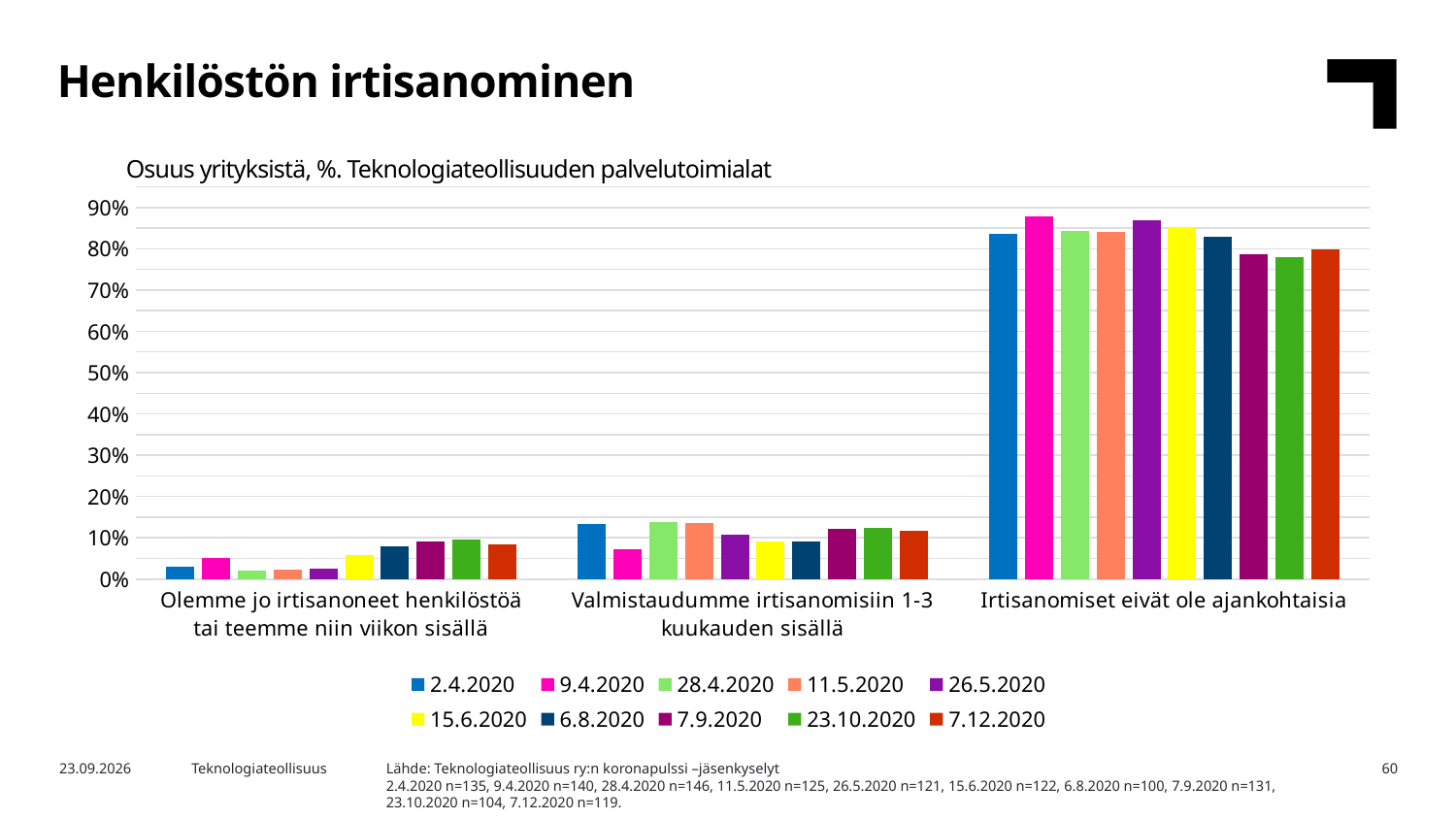
What is the subtitle shown above the chart? Osuus yrityksistä, %. Teknologiateollisuuden palvelutoimialat What kind of chart is shown on the slide? Bar chart Is the value for 2.4.2020 in the category 'Irtisanomiset eivät ole ajankohtaisia' greater or less than 80%? greater How many categories are shown on the x axis of the chart? 3 How many series does the legend list? 10 Is the value for 2.4.2020 in the category 'Olemme jo irtisanoneet henkilöstöä tai teemme niin viikon sisällä' greater or less than 10%? less In the category 'Olemme jo irtisanoneet henkilöstöä tai teemme niin viikon sisällä', which is larger: the value for 2.4.2020 or for 7.9.2020? 7.9.2020 Is the value for 28.4.2020 in the category 'Valmistaudumme irtisanomisiin 1-3 kuukauden sisällä' greater or less than 10%? greater In the category 'Valmistaudumme irtisanomisiin 1-3 kuukauden sisällä', which is larger: the value for 2.4.2020 or for 9.4.2020? 2.4.2020 Which category has the highest values in the chart? Irtisanomiset eivät ole ajankohtaisia Do the bars for 2.4.2020 rise or fall across the three categories from left to right? rise